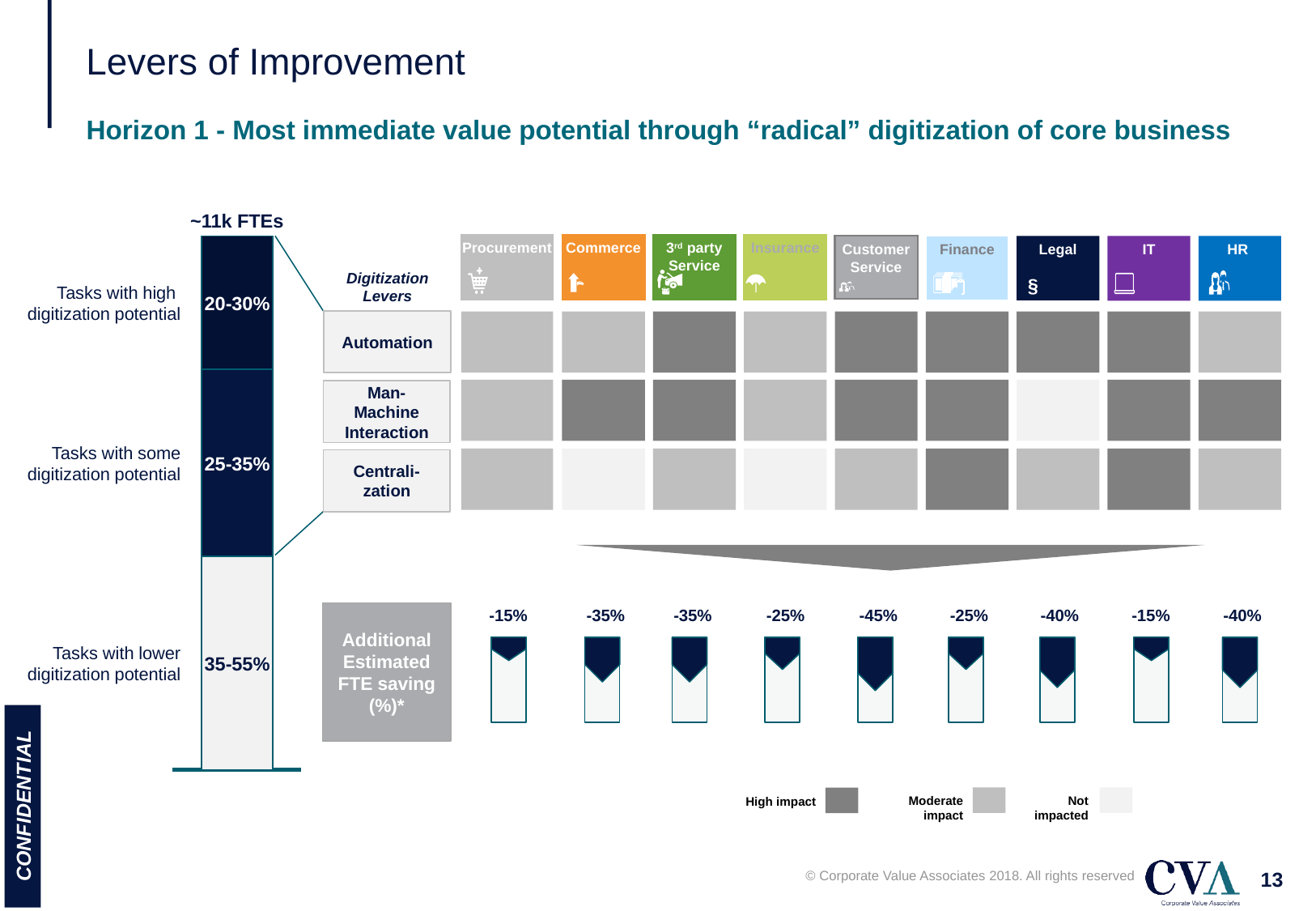
What kind of chart is shown on the left of the slide with the 20-30%, 25-35% and 35-55% segments? Stacked bar chart How many segments does the stacked bar on the left have? 3 In the stacked bar on the left, what percentage range is shown for tasks with high digitization potential? 20-30% In the stacked bar on the left, what percentage range is shown for tasks with some digitization potential? 25-35% In the Additional Estimated FTE saving row, which has the larger estimated saving, Commerce or Procurement? Commerce In the stacked bar on the left, what percentage range is shown for tasks with lower digitization potential? 35-55% In the Additional Estimated FTE saving row, what is the value for Customer Service? -45% What total FTE figure is labelled above the stacked bar on the left? ~11k FTEs What three impact levels does the legend at the bottom of the matrix list? High impact, Moderate impact, Not impacted In the Additional Estimated FTE saving row, which function has the largest estimated FTE saving? Customer Service In the Additional Estimated FTE saving row, what is the value for Legal? -40% How many functions are shown across the top of the digitization levers matrix? 9